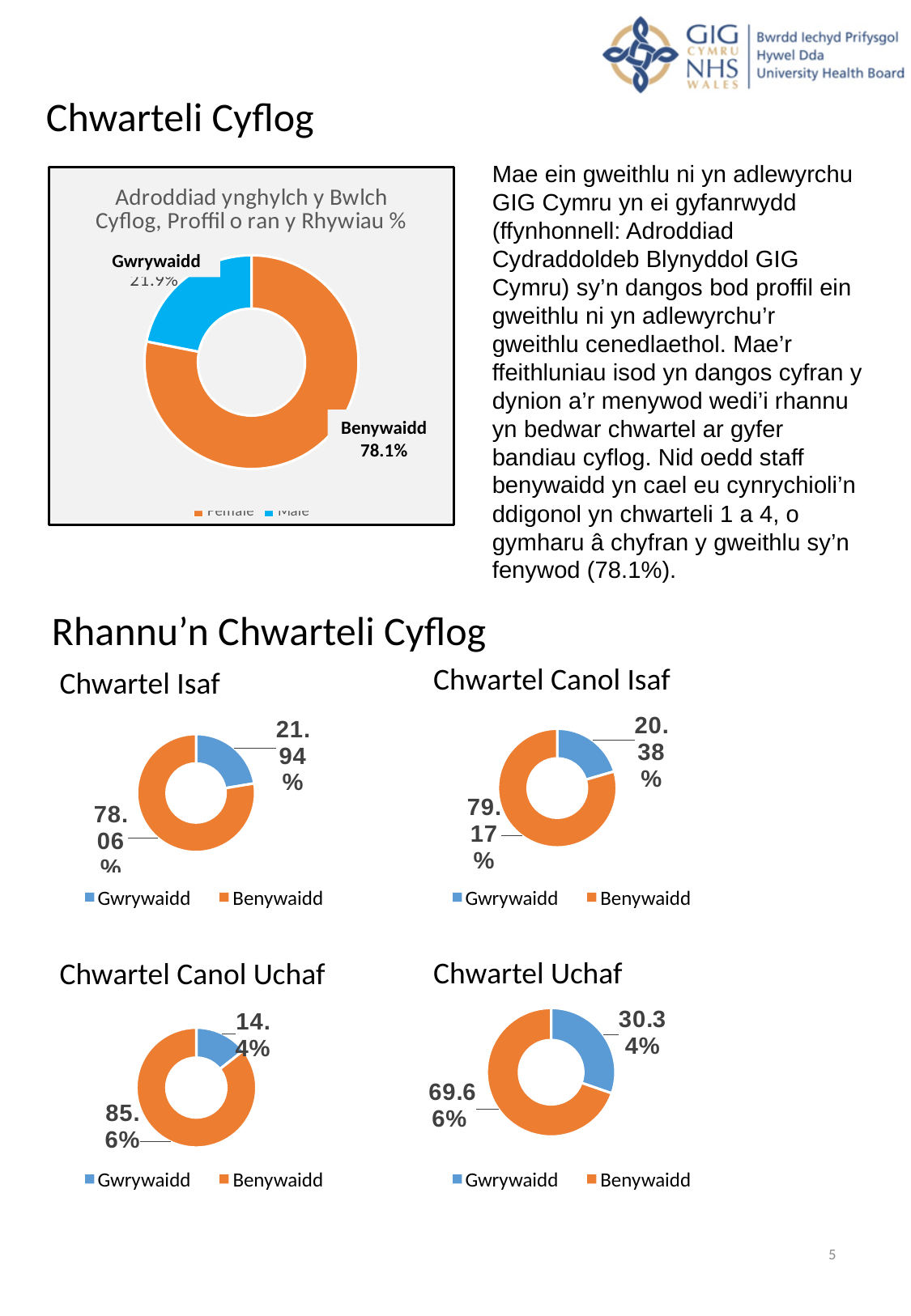
What kind of chart is the 'Chwartel Isaf' chart? Doughnut chart In the 'Chwartel Uchaf' chart, what is the value for Gwrywaidd? 30.34% In the 'Chwartel Canol Isaf' chart, what is the value for Benywaidd? 79.17% How many entries does the legend of the 'Chwartel Canol Isaf' chart list? 2 In the 'Chwartel Uchaf' chart, which category is larger, Gwrywaidd or Benywaidd? Benywaidd In the 'Chwartel Canol Uchaf' chart, what is the difference between the Benywaidd and Gwrywaidd values? 71.2% In the 'Chwartel Canol Uchaf' chart, what is the value for Gwrywaidd? 14.4% In the 'Chwartel Isaf' chart, what is the value for Gwrywaidd? 21.94% In the 'Chwartel Canol Isaf' chart, what is the value for Gwrywaidd? 20.38% In the 'Chwartel Isaf' chart, what is the value for Benywaidd? 78.06% In the 'Chwartel Uchaf' chart, what is the value for Benywaidd? 69.66% In the top chart titled 'Adroddiad ynghylch y Bwlch Cyflog, Proffil o ran y Rhywiau %', what is the value for Benywaidd? 78.1%